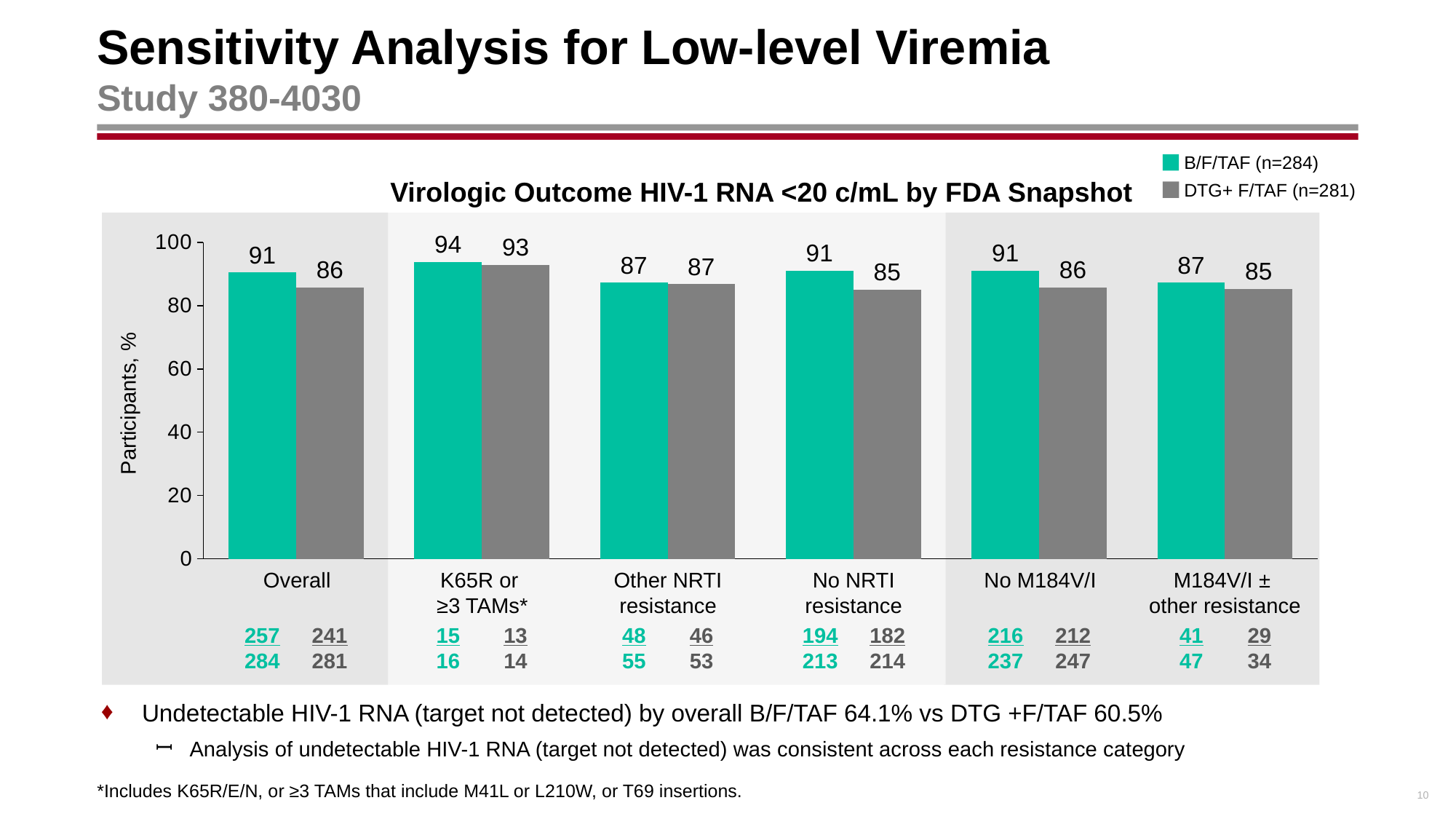
What is the difference between the B/F/TAF and DTG+ F/TAF values for the Overall category? 5 What is the difference between the B/F/TAF and DTG+ F/TAF values for the No NRTI resistance category? 6 What is the title of the chart? Virologic Outcome HIV-1 RNA <20 c/mL by FDA Snapshot How many categories are shown on the x axis? 6 What is the B/F/TAF value for the Overall category? 91 What is the DTG+ F/TAF value for the No NRTI resistance category? 85 Which category has the highest DTG+ F/TAF value? K65R or ≥3 TAMs* Which category has the highest B/F/TAF value? K65R or ≥3 TAMs* What kind of chart is shown on the slide? Bar chart What is the B/F/TAF value for the K65R or ≥3 TAMs* category? 94 Which is larger for the M184V/I ± other resistance category, the B/F/TAF value or the DTG+ F/TAF value? B/F/TAF How many series does the legend list? 2